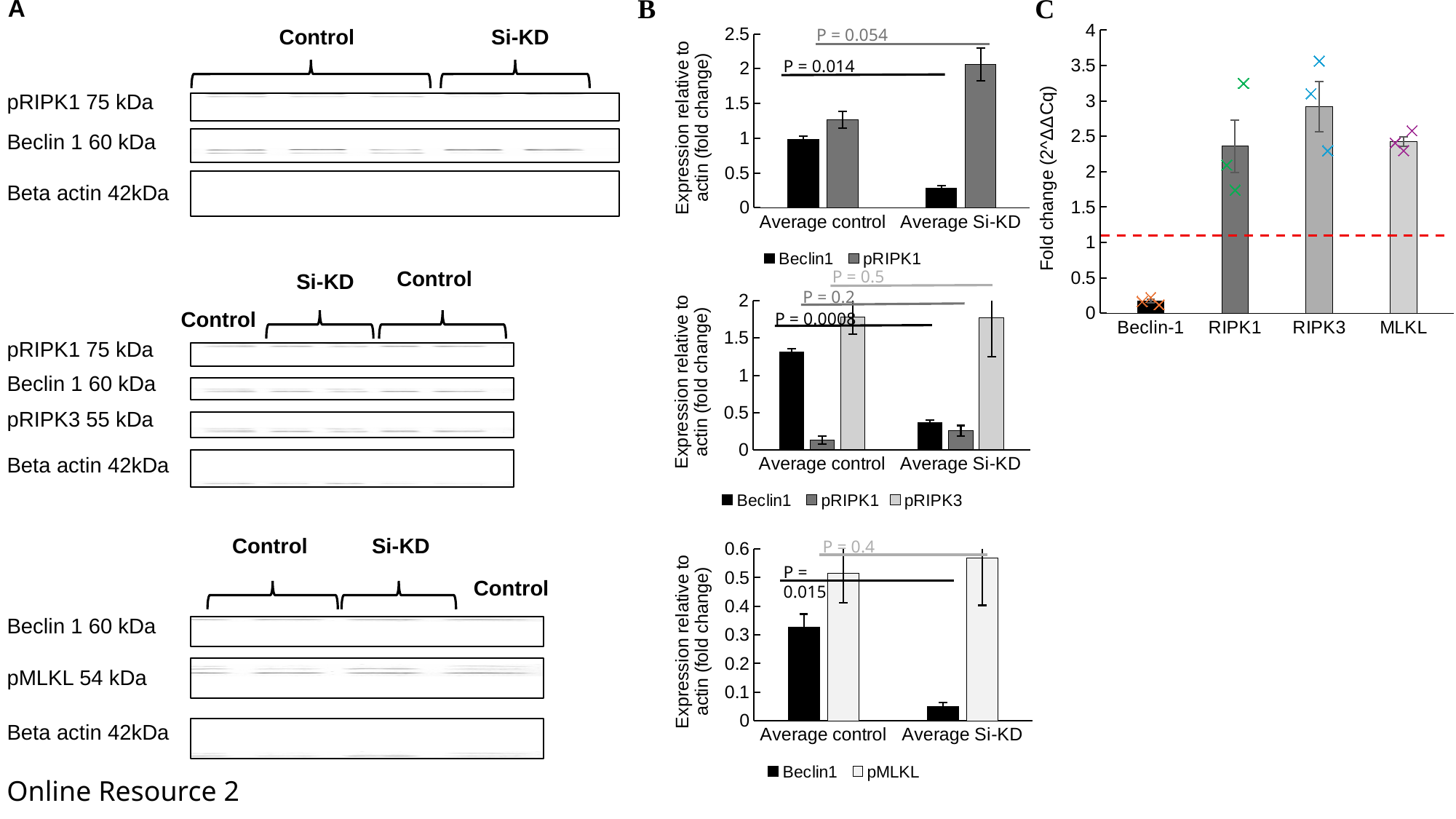
In the chart in panel C, which category has the highest fold change? RIPK3 In the middle chart of panel B, for Average control, which is larger: Beclin1 or pRIPK1? Beclin1 In the top chart of panel B, is the Beclin1 value for Average Si-KD greater or less than 0.5? less In the top chart of panel B, how many series does the legend list? 2 What kind of chart is shown in panel C? bar chart In the middle chart of panel B, how many series does the legend list? 3 In the chart in panel C, which category has the lowest fold change? Beclin-1 In the top chart of panel B, is the pRIPK1 value for Average Si-KD greater or less than 1.5? greater In the chart in panel C, how many categories are shown on the x axis? 4 In the chart in panel C, is the fold change for RIPK1 greater or less than 2? greater